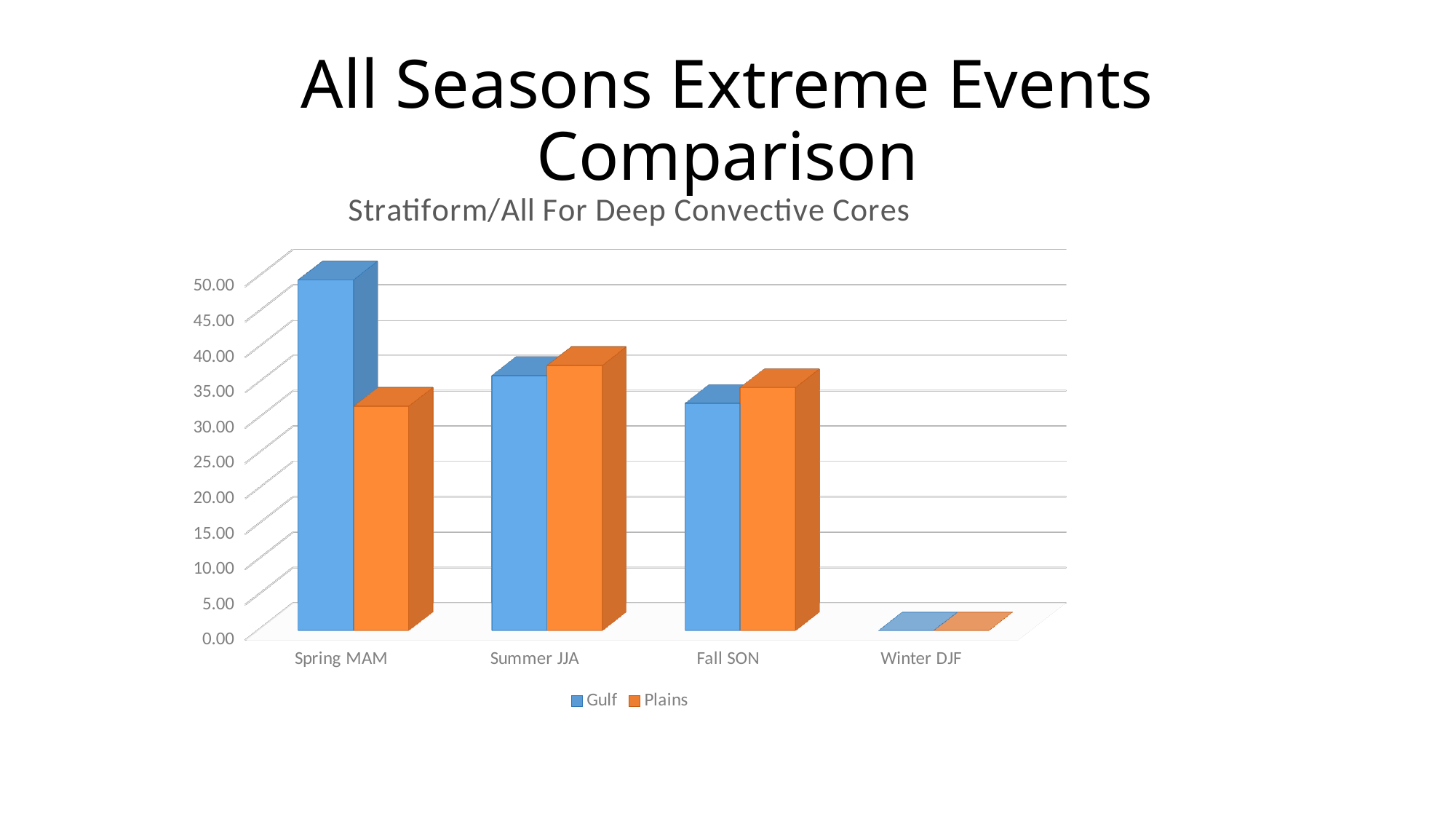
Which season has the highest Gulf value? Spring MAM What is the title of the chart? Stratiform/All For Deep Convective Cores For Spring MAM, which is larger, the Gulf value or the Plains value? Gulf How many series does the legend list? 2 Is the Plains value for Spring MAM greater or less than 35.00? less Which season has the lowest Plains value? Winter DJF What kind of chart is shown on the slide? bar chart Is the Gulf value for Spring MAM greater or less than 45.00? greater Is the Plains value for Fall SON greater or less than 40.00? less How many seasons (categories) are shown on the x axis? 4 What are the two series named in the legend? Gulf and Plains